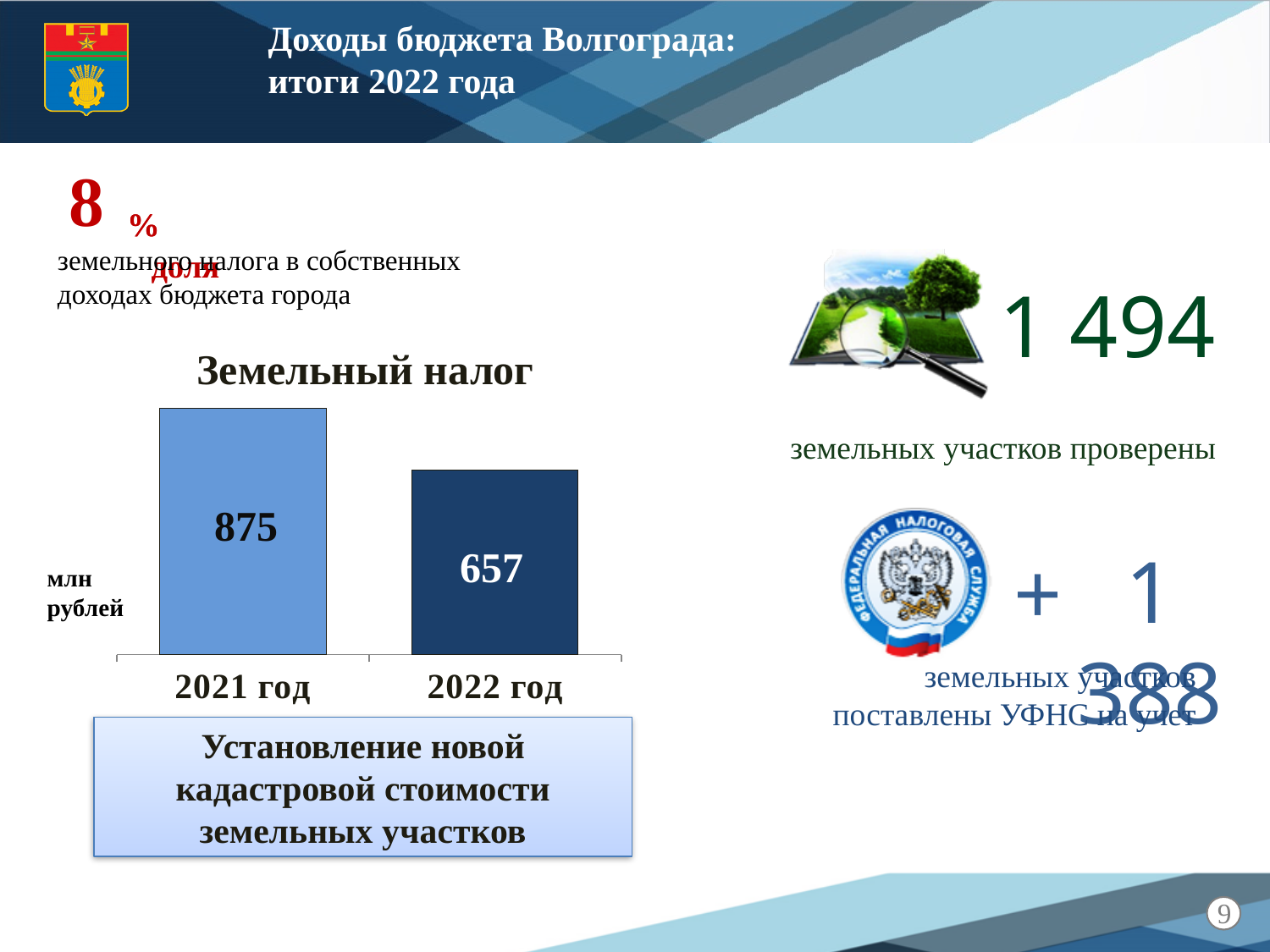
What is the value for 2022 год in the Земельный налог chart? 657 Which year has the highest value in the Земельный налог chart? 2021 год How many bars are shown in the Земельный налог chart? 2 What is the value for 2021 год in the Земельный налог chart? 875 What is the title of the bar chart on the slide? Земельный налог What unit is indicated next to the bars in the Земельный налог chart? млн рублей Which year has the lowest value in the Земельный налог chart? 2022 год Which is larger in the Земельный налог chart, the value for 2021 год or for 2022 год? 2021 год What kind of chart is the Земельный налог chart? bar chart Do the values in the Земельный налог chart rise or fall from 2021 год to 2022 год? fall What is the difference between the 2021 год and 2022 год values in the Земельный налог chart? 218